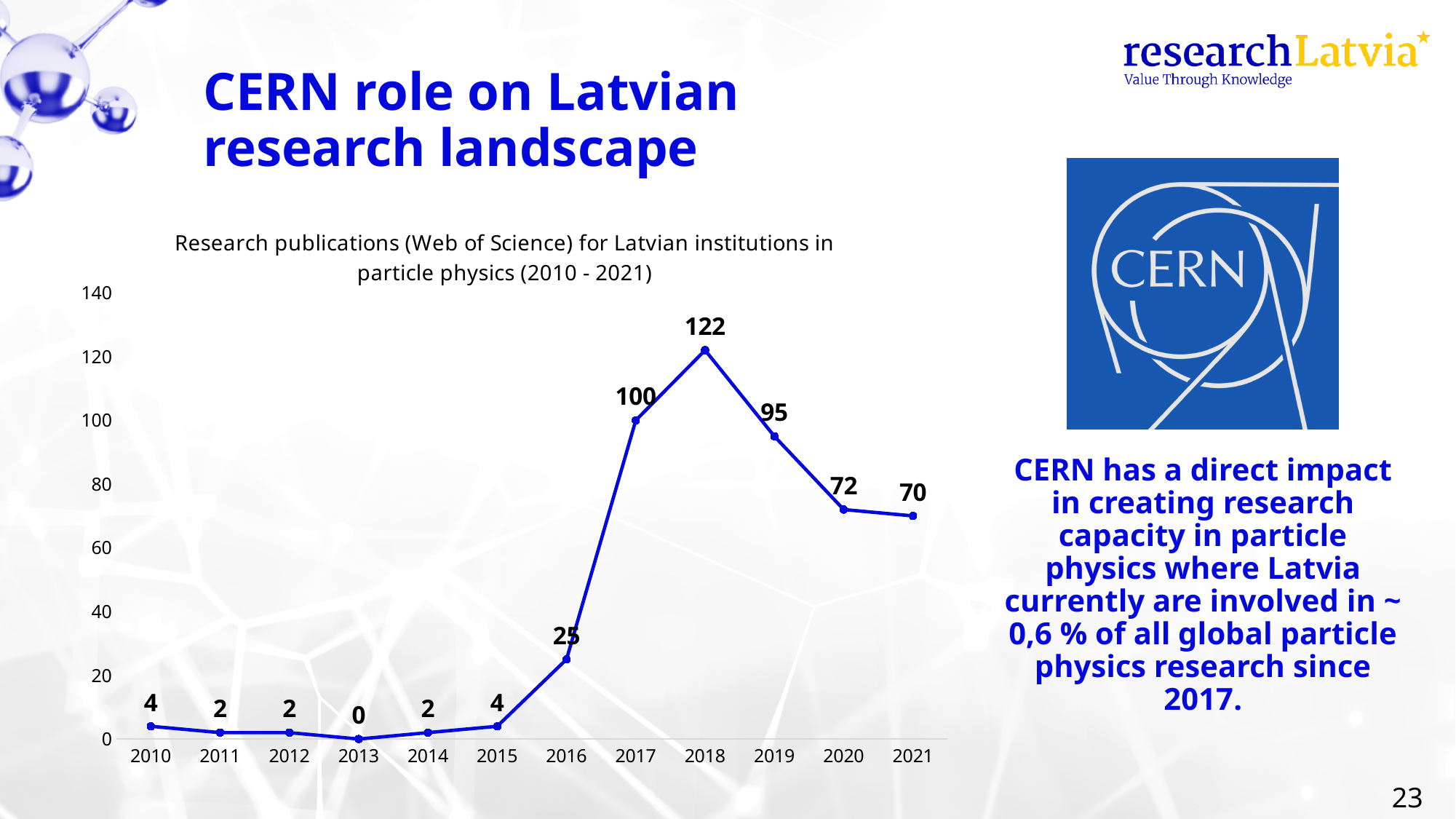
What is the number of research publications in 2016? 25 What is the difference between the number of publications in 2019 and 2021? 25 What kind of chart is shown on the slide? line chart What is the number of research publications in 2018? 122 Which year has the lowest number of research publications? 2013 What is the difference between the number of publications in 2018 and 2017? 22 Do the values rise or fall from 2018 to 2021? fall What is the title of the chart? Research publications (Web of Science) for Latvian institutions in particle physics (2010 - 2021) What is the number of research publications in 2013? 0 Which year has the highest number of research publications? 2018 How many years are plotted on the chart? 12 Which year has more publications, 2020 or 2016? 2020